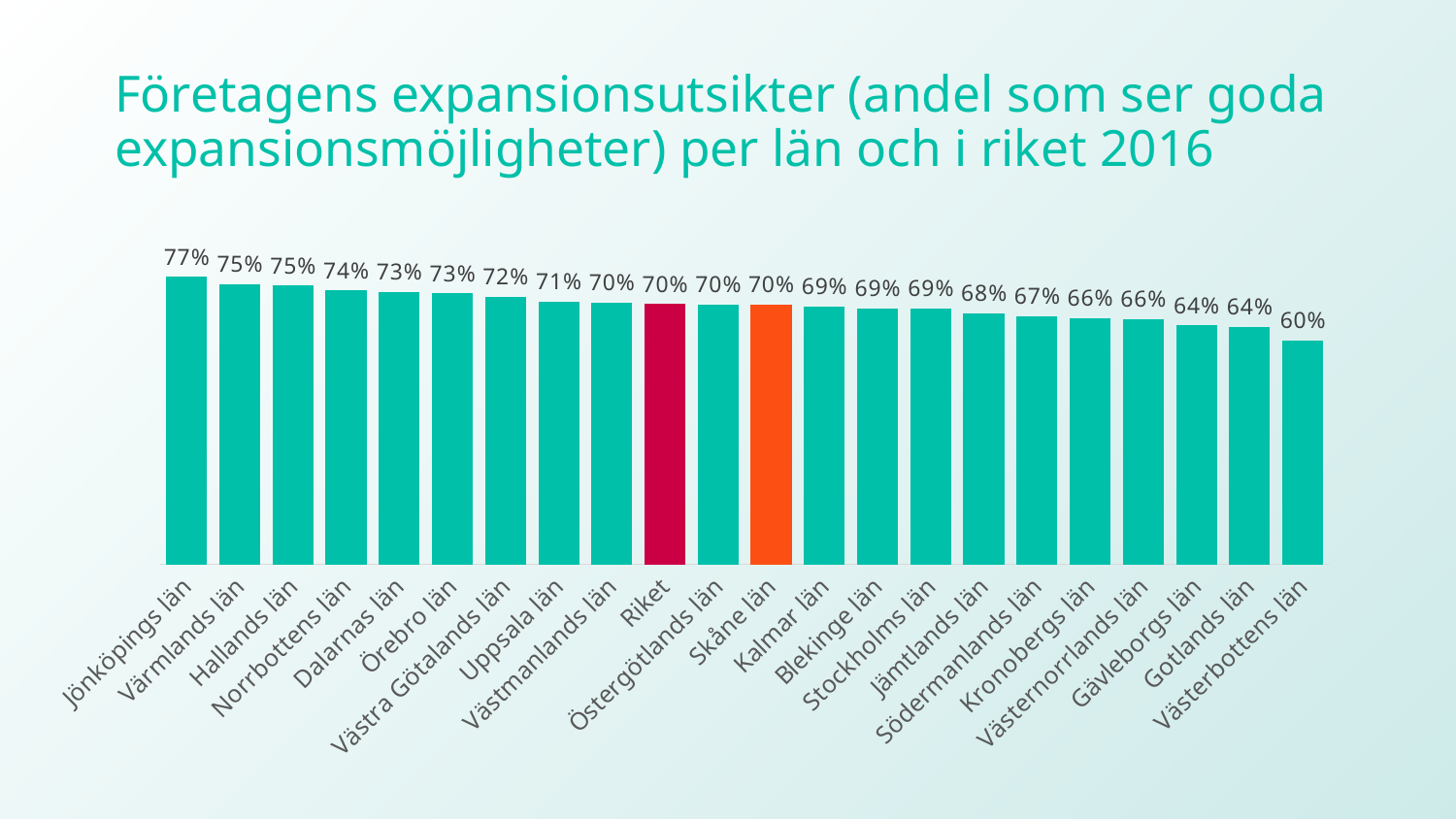
What is the value for Skåne län? 70% Which category has the lowest value? Västerbottens län What is the value for Jönköpings län? 77% Do the values rise or fall from left to right along the x axis? Fall What is the value for Riket? 70% What is the value for Stockholms län? 69% Which bar is coloured orange? Skåne län How many bars are shown in the chart? 22 What kind of chart is shown on the slide? Bar chart Which category has the highest value? Jönköpings län What is the difference between the values for Jönköpings län and Västerbottens län? 17 percentage points Which is larger, the value for Norrbottens län or the value for Gotlands län? Norrbottens län